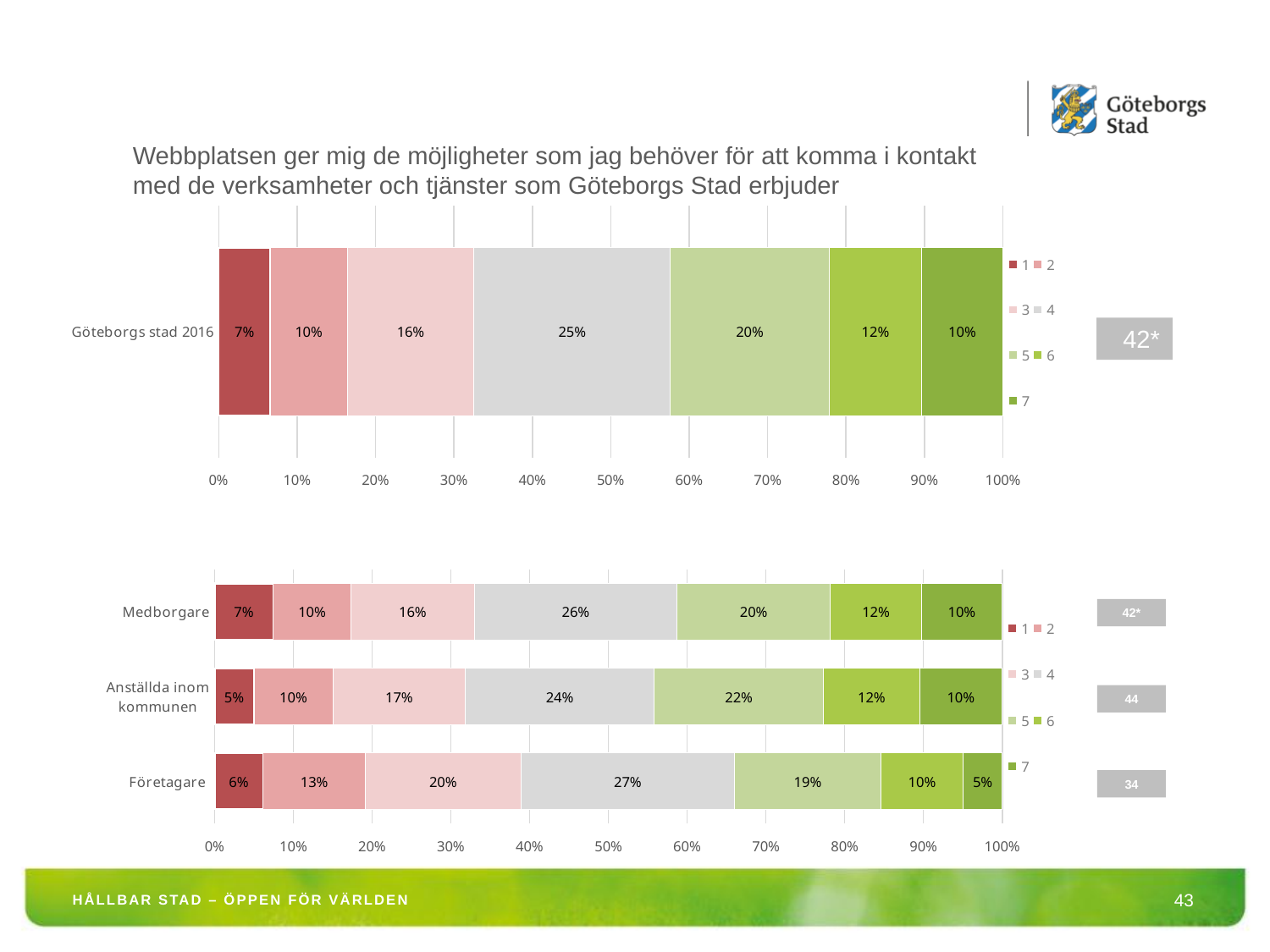
What kind of chart is the top chart? Stacked bar chart In the bottom chart, which category has the lowest value for series 7? Företagare In the bottom chart, what is the value for series 1 for Anställda inom kommunen? 5% In the bottom chart, what is the value for series 4 for Företagare? 27% In the bottom chart, how many categories are shown? 3 In the bottom chart, which category has the highest value for series 3? Företagare In the bottom chart, what is the value for series 3 for Medborgare? 16% In the bottom chart, which has the larger series 5 value, Anställda inom kommunen or Företagare? Anställda inom kommunen In the bottom chart, what is the difference between the series 2 value for Företagare and for Medborgare? 3 percentage points In the top chart, what is the value for series 4 for Göteborgs stad 2016? 25% In the top chart, how many series does the legend list? 7 In the top chart, which series has the largest share of the Göteborgs stad 2016 bar? 4